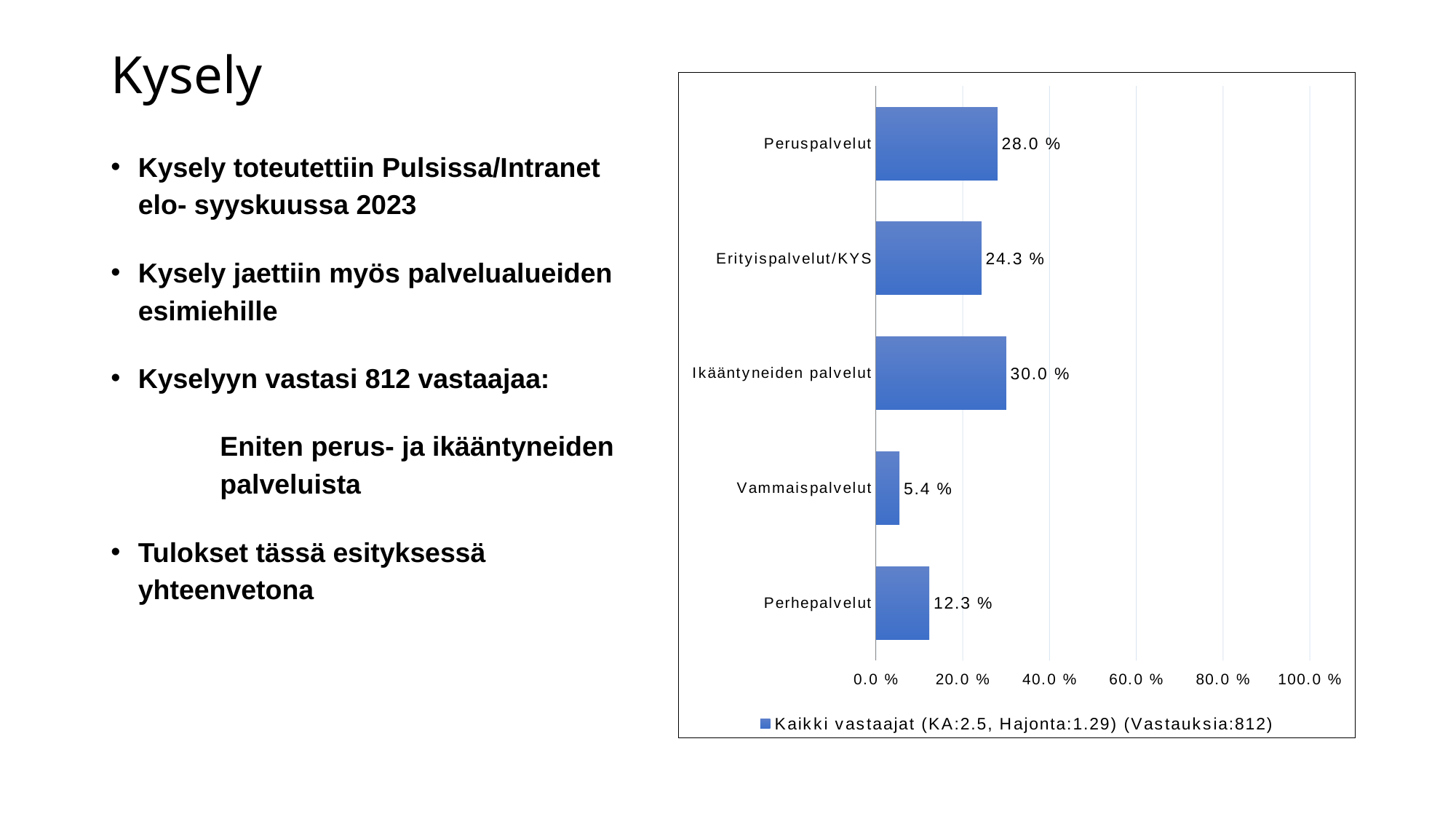
What is the legend entry of the chart? Kaikki vastaajat (KA:2.5, Hajonta:1.29) (Vastauksia:812) What is the value for Peruspalvelut? 28.0 % What is the value for Vammaispalvelut? 5.4 % Is the value for Perhepalvelut greater or less than 20.0 %? less What is the difference between the values for Ikääntyneiden palvelut and Erityispalvelut/KYS? 5.7 % What kind of chart is shown on the slide? bar chart Which is larger, the value for Peruspalvelut or the value for Erityispalvelut/KYS? Peruspalvelut Which category has the lowest value? Vammaispalvelut How many series does the legend list? 1 What is the value for Perhepalvelut? 12.3 % How many categories are shown in the chart? 5 Which category has the highest value? Ikääntyneiden palvelut